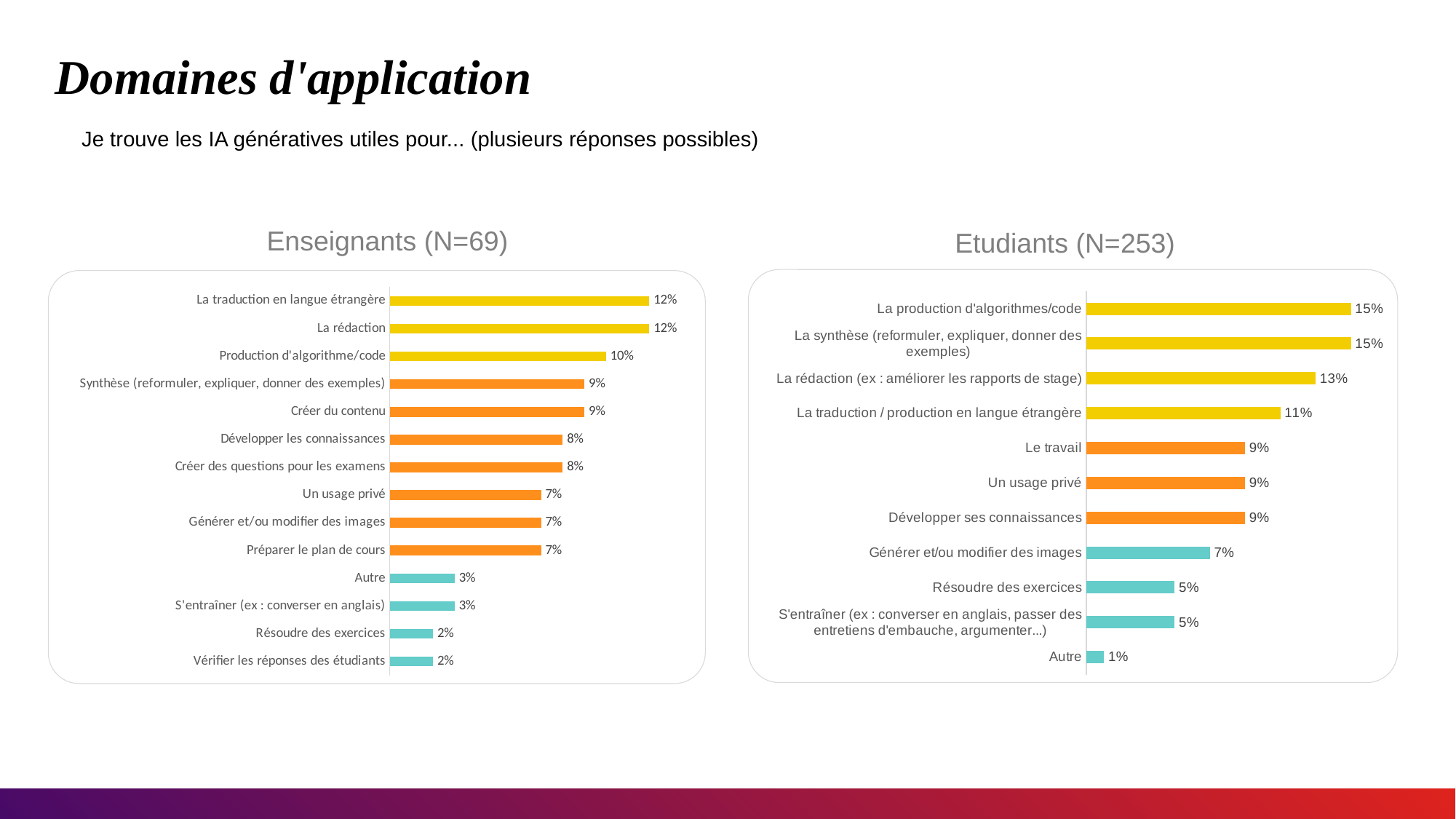
What type of chart is the Etudiants (N=253) chart? Bar chart How many categories are shown in the Etudiants (N=253) chart? 11 In the Enseignants (N=69) chart, what is the value for Production d'algorithme/code? 10% In the Enseignants (N=69) chart, what is the difference between La rédaction and Résoudre des exercices? 10% In the Enseignants (N=69) chart, what is the highest value shown? 12% In the Etudiants (N=253) chart, which category has the lowest value? Autre In the Enseignants (N=69) chart, which is larger: Créer du contenu or Un usage privé? Créer du contenu In the Etudiants (N=253) chart, what is the value for Générer et/ou modifier des images? 7% In the Etudiants (N=253) chart, what is the difference between La production d'algorithmes/code and La traduction / production en langue étrangère? 4% How many categories are shown in the Enseignants (N=69) chart? 14 In the Enseignants (N=69) chart, what is the value for Préparer le plan de cours? 7% In the Etudiants (N=253) chart, what is the value for La rédaction (ex : améliorer les rapports de stage)? 13%